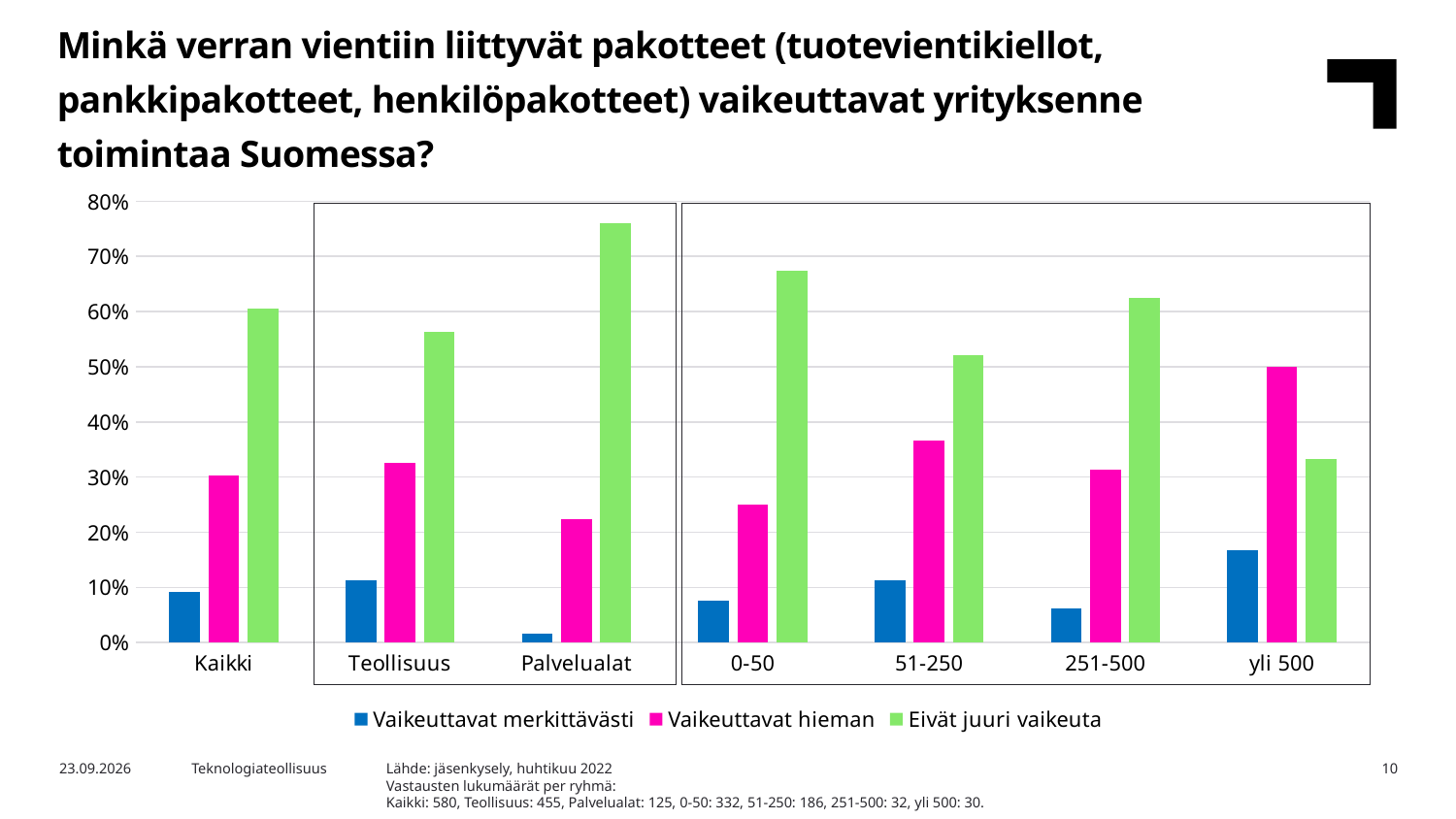
Which has the larger 'Eivät juuri vaikeuta' value, 0-50 or 51-250? 0-50 What are the three legend entries of the chart? Vaikeuttavat merkittävästi, Vaikeuttavat hieman, Eivät juuri vaikeuta Which category has the lowest value for 'Vaikeuttavat merkittävästi'? Palvelualat Which category has the highest value for 'Vaikeuttavat merkittävästi'? yli 500 Which has the larger 'Vaikeuttavat hieman' value, Teollisuus or Palvelualat? Teollisuus Is the 'Vaikeuttavat merkittävästi' value for Teollisuus greater or less than 20%? less Is the 'Eivät juuri vaikeuta' value for Kaikki greater or less than 50%? greater What kind of chart is shown on the slide? bar chart How many series does the legend list? 3 How many categories are shown on the x axis? 7 Is the 'Vaikeuttavat hieman' value for yli 500 greater or less than 40%? greater Which category has the highest value for 'Eivät juuri vaikeuta'? Palvelualat